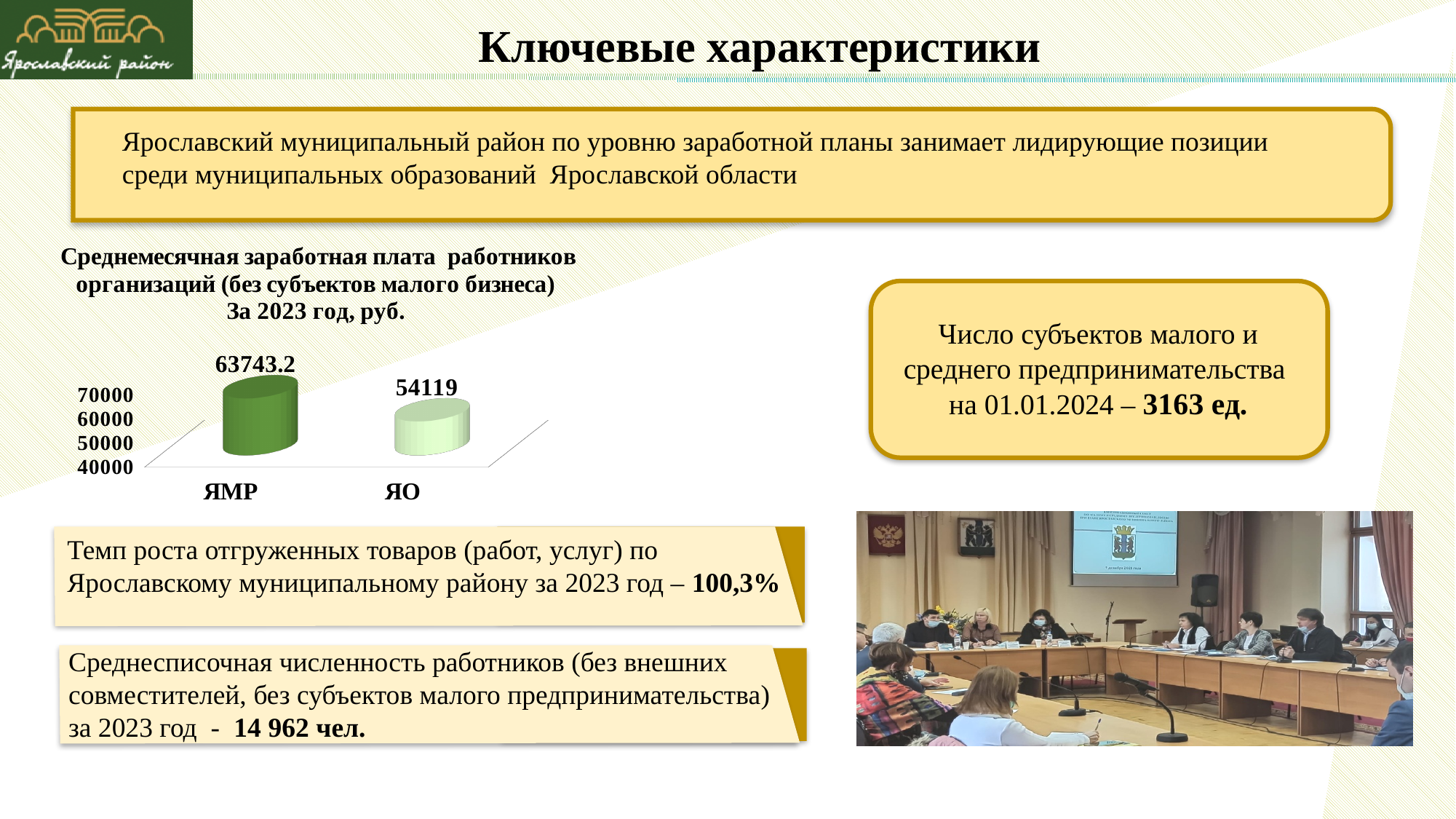
What is the average monthly salary value shown for ЯО? 54119 Which category has the highest value in the chart? ЯМР For which year does the chart show the average monthly salary? 2023 What is the difference between the values for ЯМР and ЯО? 9624.2 How many categories are shown in the chart? 2 Is the value for ЯО greater or less than 60000? less What is the highest tick value shown on the vertical axis of the chart? 70000 Which category has the higher value, ЯМР or ЯО? ЯМР What kind of chart is shown on the slide? bar chart Which category has the lowest value in the chart? ЯО Is the value for ЯМР greater or less than 60000? greater What is the average monthly salary value shown for ЯМР? 63743.2